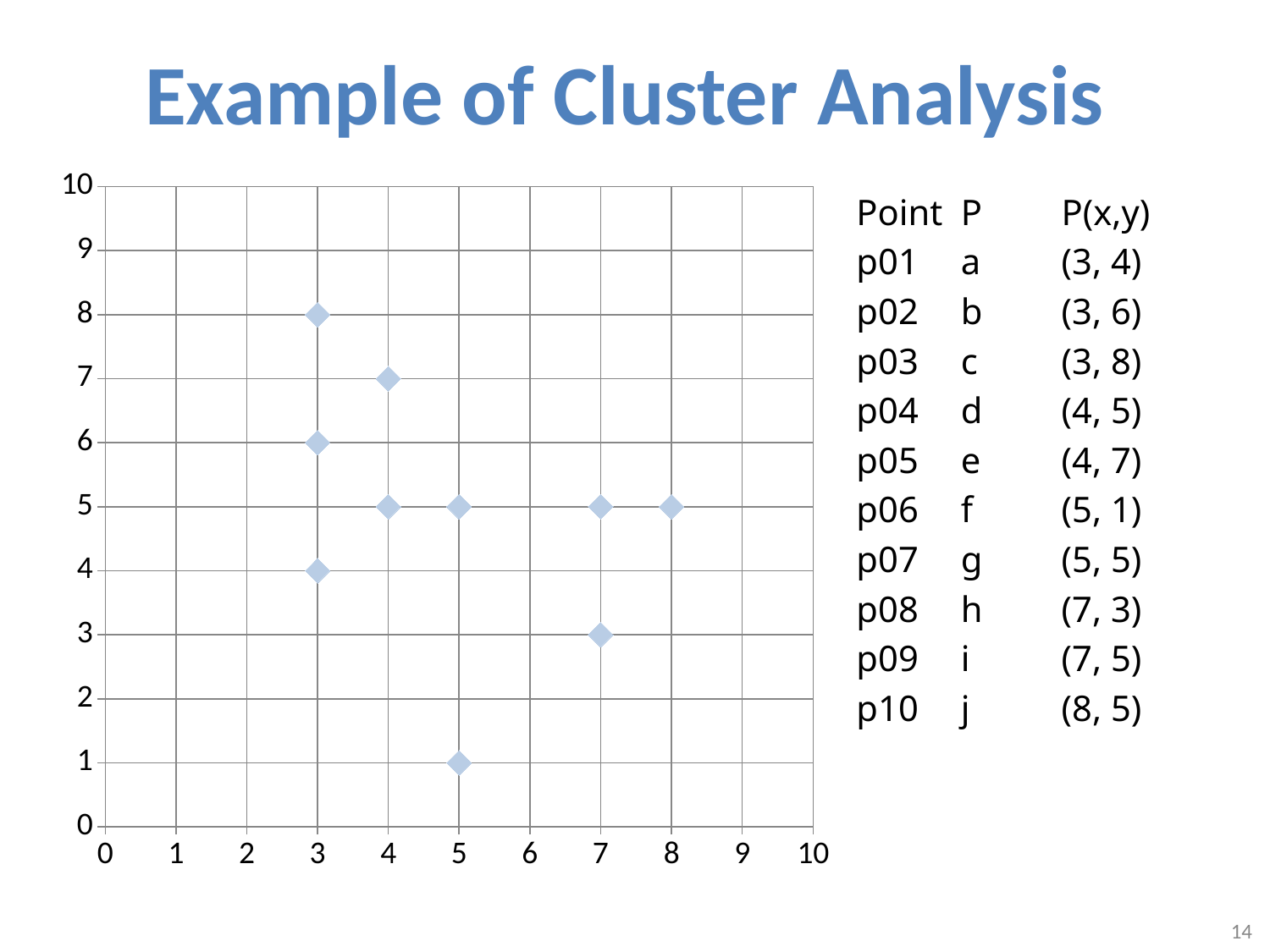
What is the y value of the point plotted at x = 8? 5 What is the y value of the highest point on the chart? 8 How many points are plotted at y = 5? 4 How many points are plotted on the chart? 10 What is the x value of the highest point on the chart? 3 What is the title of the slide containing the chart? Example of Cluster Analysis How many points are plotted at x = 3? 3 What is the maximum value shown on the x axis? 10 What is the y value of the lowest point on the chart? 1 Which has the larger y value: the point at x = 5, y = 1 or the point at x = 7, y = 3? the point at (7, 3) What is the difference in y between the highest point and the lowest point? 7 What kind of chart is shown on the slide? scatter chart